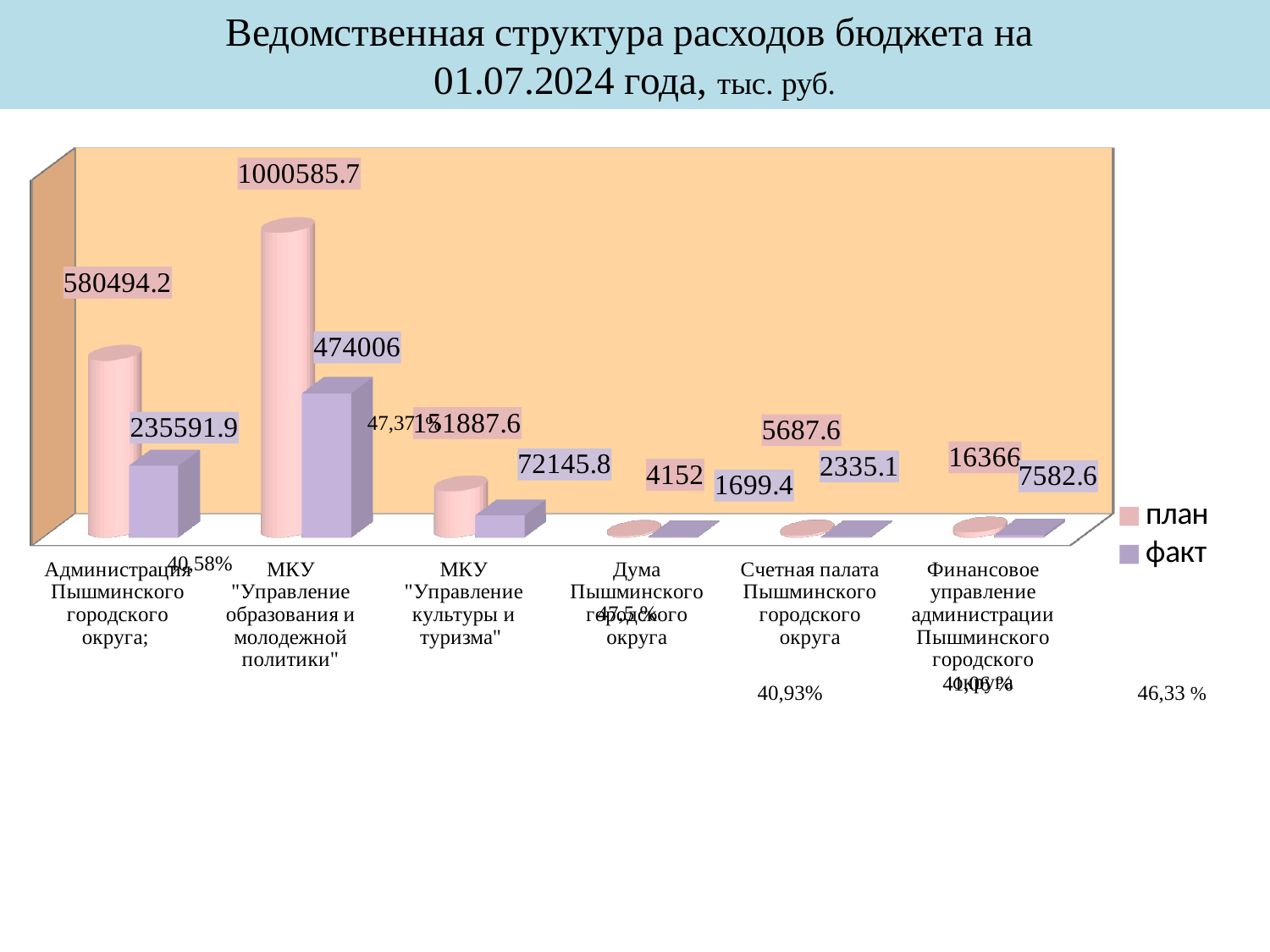
Which has the larger план value: Счетная палата Пышминского городского округа or Дума Пышминского городского округа? Счетная палата Пышминского городского округа What is the факт value for Финансовое управление администрации Пышминского городского округа? 7582.6 How many series does the legend list? 2 What kind of chart is shown on the slide? bar chart What is the difference between the план and факт values for Администрация Пышминского городского округа? 344902.3 What is the план value for Администрация Пышминского городского округа? 580494.2 What is the план value for Дума Пышминского городского округа? 4152 Which category has the highest план value? МКУ "Управление образования и молодежной политики" Which category has the lowest факт value? Дума Пышминского городского округа What is the факт value for МКУ "Управление образования и молодежной политики"? 474006 What are the two entries in the legend? план, факт How many categories are shown on the x axis? 6